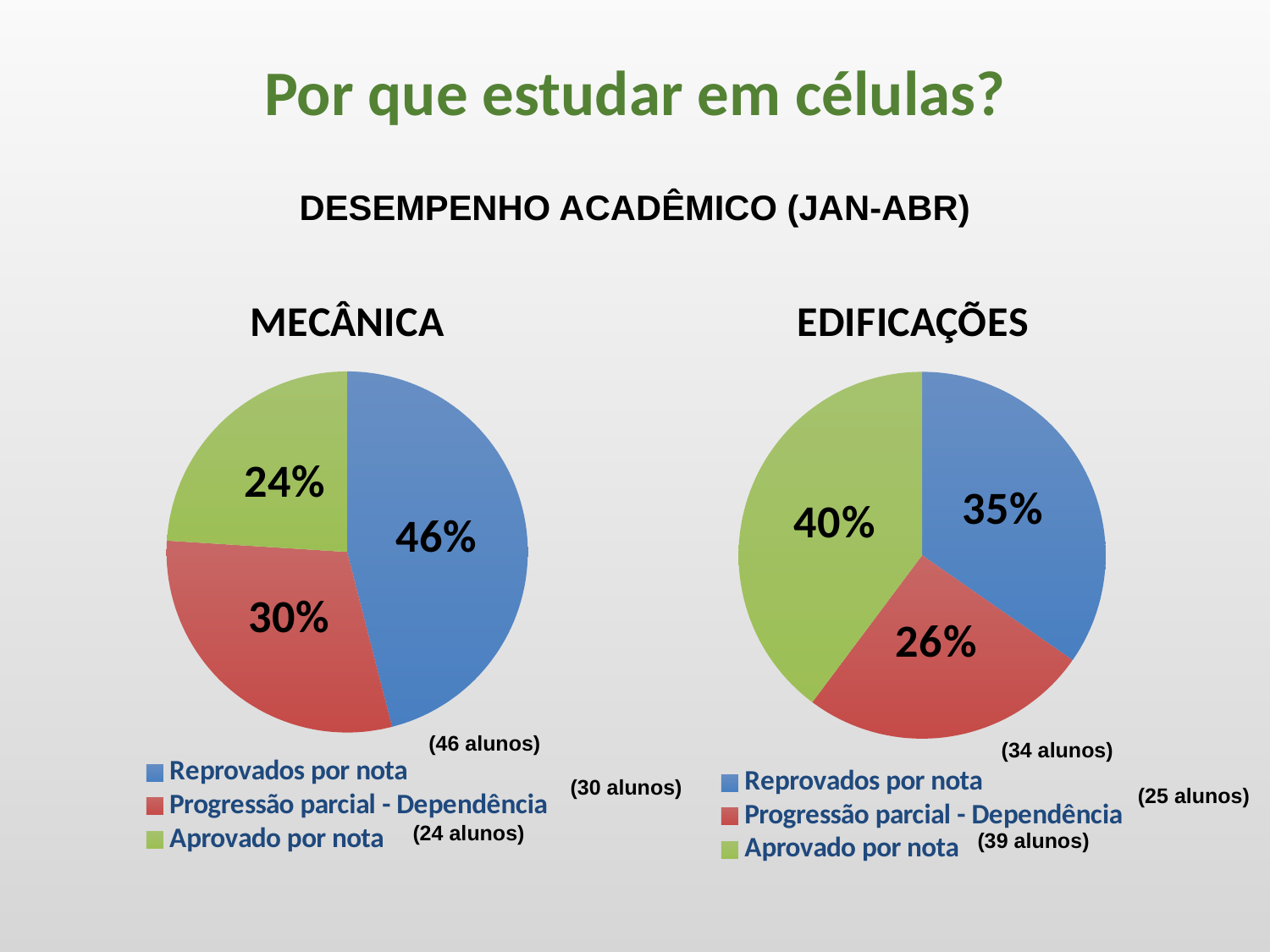
In the EDIFICAÇÕES chart, which category has the smallest slice? Progressão parcial - Dependência In the EDIFICAÇÕES chart, what share is Progressão parcial - Dependência? 26% What kind of chart is the MECÂNICA chart? Pie chart In the EDIFICAÇÕES chart, what share is Aprovado por nota? 40% In the MECÂNICA chart, what share is Progressão parcial - Dependência? 30% How many slices does the EDIFICAÇÕES pie chart have? 3 In the MECÂNICA chart, which category has the largest slice? Reprovados por nota What is the difference in percentage points between Reprovados por nota and Aprovado por nota in the MECÂNICA chart? 22 percentage points Which chart has the larger share of Aprovado por nota, MECÂNICA or EDIFICAÇÕES? EDIFICAÇÕES